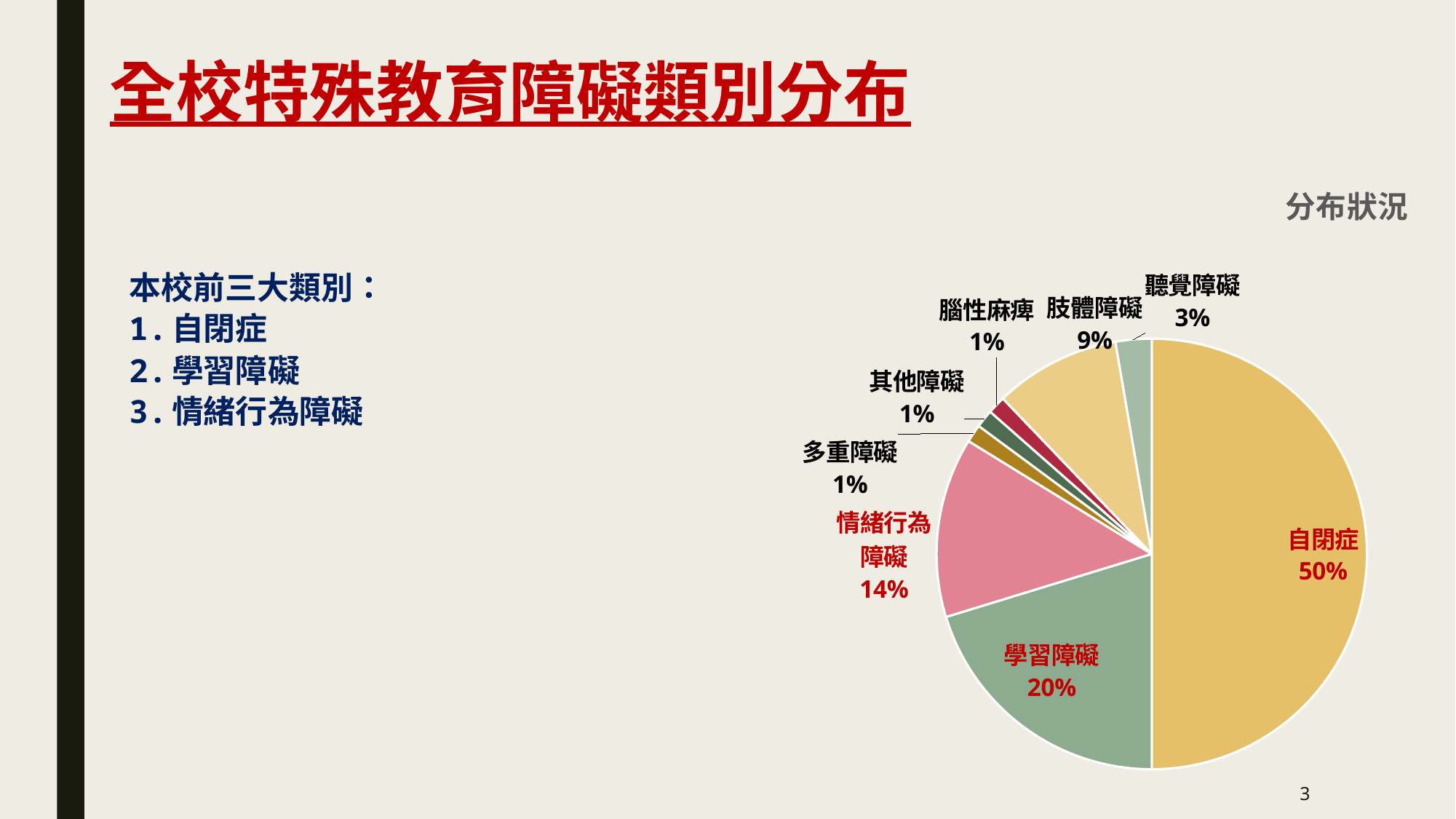
What percentage of the pie does 自閉症 account for? 50% How many categories are shown in the pie chart? 8 What type of chart is shown on the slide? pie chart What is the title of the chart? 分布狀況 What is the value shown for 聽覺障礙? 3% Which category has the largest slice of the pie? 自閉症 What is the value shown for 肢體障礙? 9% What is the difference between the values for 學習障礙 and 情緒行為障礙? 6% What is the difference between the values for 自閉症 and 學習障礙? 30% What is the value shown for 學習障礙? 20% What is the value shown for 情緒行為障礙? 14% Which is larger, the value for 肢體障礙 or the value for 聽覺障礙? 肢體障礙